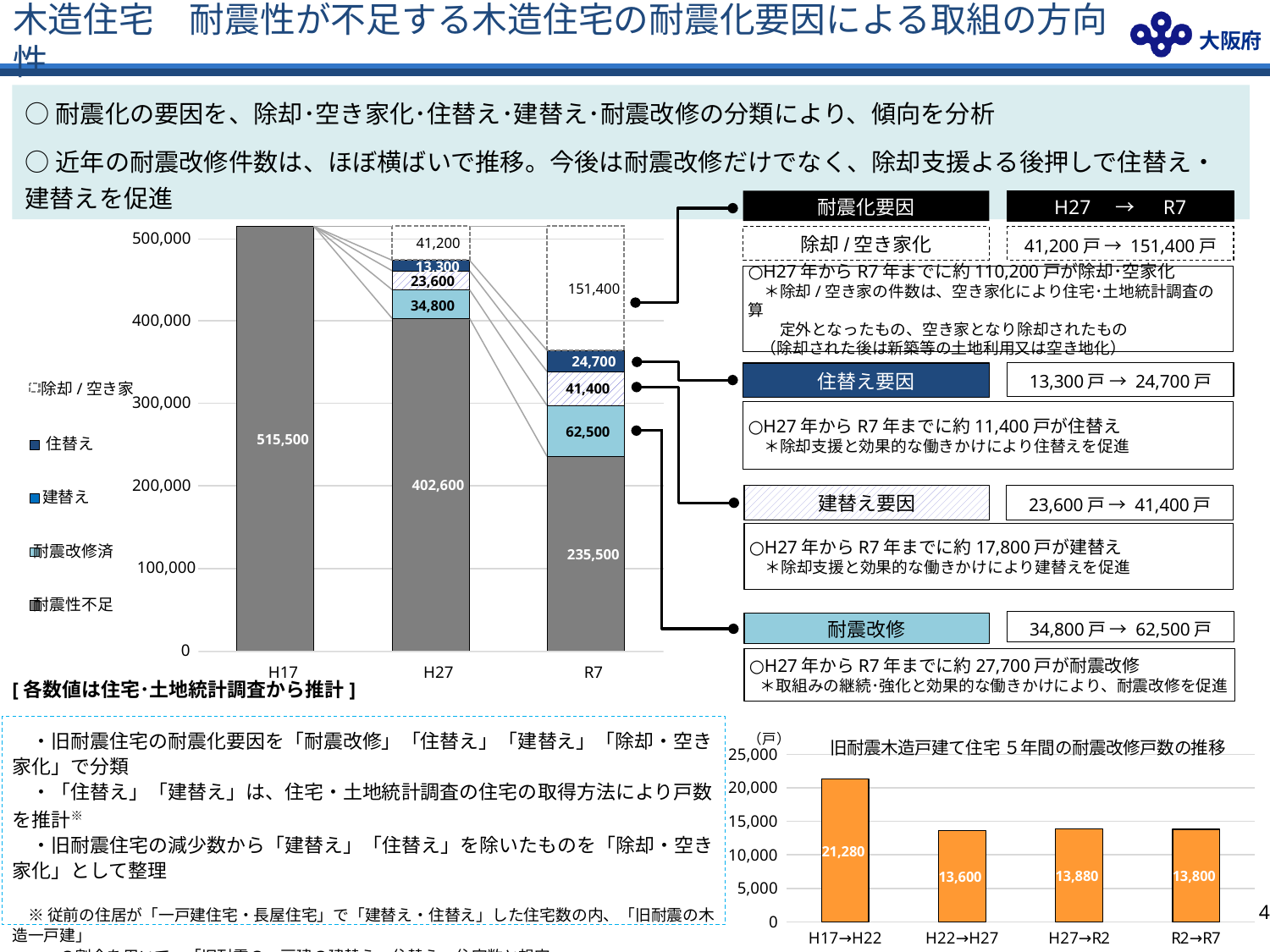
In the stacked bar chart on the left, which is larger: 住替え for H27 or 住替え for R7? R7 What type of chart is the chart at the bottom right titled 旧耐震木造戸建て住宅５年間の耐震改修戸数の推移? bar chart How many series does the legend of the stacked bar chart on the left list? 5 In the stacked bar chart on the left, what is the total of the R7 stacked bar? 515,500 In the stacked bar chart on the left, what is the value of 耐震改修済 for R7? 62,500 In the stacked bar chart on the left, what is the value of 除却/空き家 for H27? 41,200 In the stacked bar chart on the left, is the 耐震性不足 value for R7 greater or less than 300,000? less How many bars are in the bar chart at the bottom right titled 旧耐震木造戸建て住宅５年間の耐震改修戸数の推移? 4 In the stacked bar chart on the left, what is the difference between the 建替え values for R7 and H27? 17,800 In the stacked bar chart on the left, what is the value of 耐震性不足 for H17? 515,500 In the bar chart at the bottom right titled 旧耐震木造戸建て住宅５年間の耐震改修戸数の推移, which period has the highest value? H17→H22 In the bar chart at the bottom right titled 旧耐震木造戸建て住宅５年間の耐震改修戸数の推移, what is the value for H27→R2? 13,880